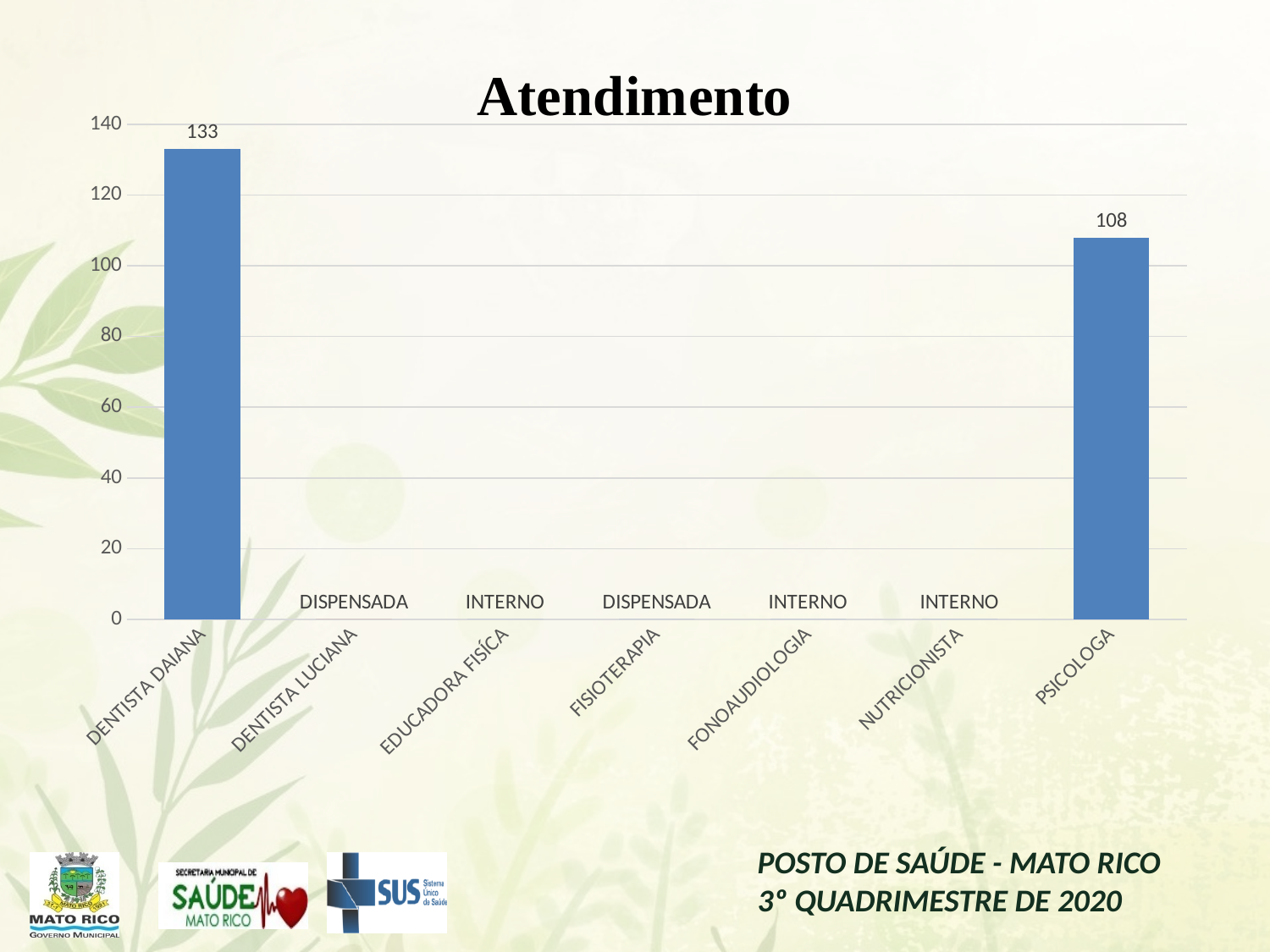
How many categories are shown on the x axis of the Atendimento chart? 7 What is the title of the chart? Atendimento Which is larger, the value for DENTISTA DAIANA or the value for PSICOLOGA? DENTISTA DAIANA What kind of chart is shown on the slide? bar chart Is the value for DENTISTA DAIANA greater or less than 120? greater What is the difference between the values for DENTISTA DAIANA and PSICOLOGA? 25 What label is shown in place of a bar for DENTISTA LUCIANA? DISPENSADA What is the value for DENTISTA DAIANA in the Atendimento chart? 133 Which category has the highest value in the Atendimento chart? DENTISTA DAIANA What is the value for PSICOLOGA in the Atendimento chart? 108 What label is shown in place of a bar for NUTRICIONISTA? INTERNO Is the value for PSICOLOGA greater or less than 120? less